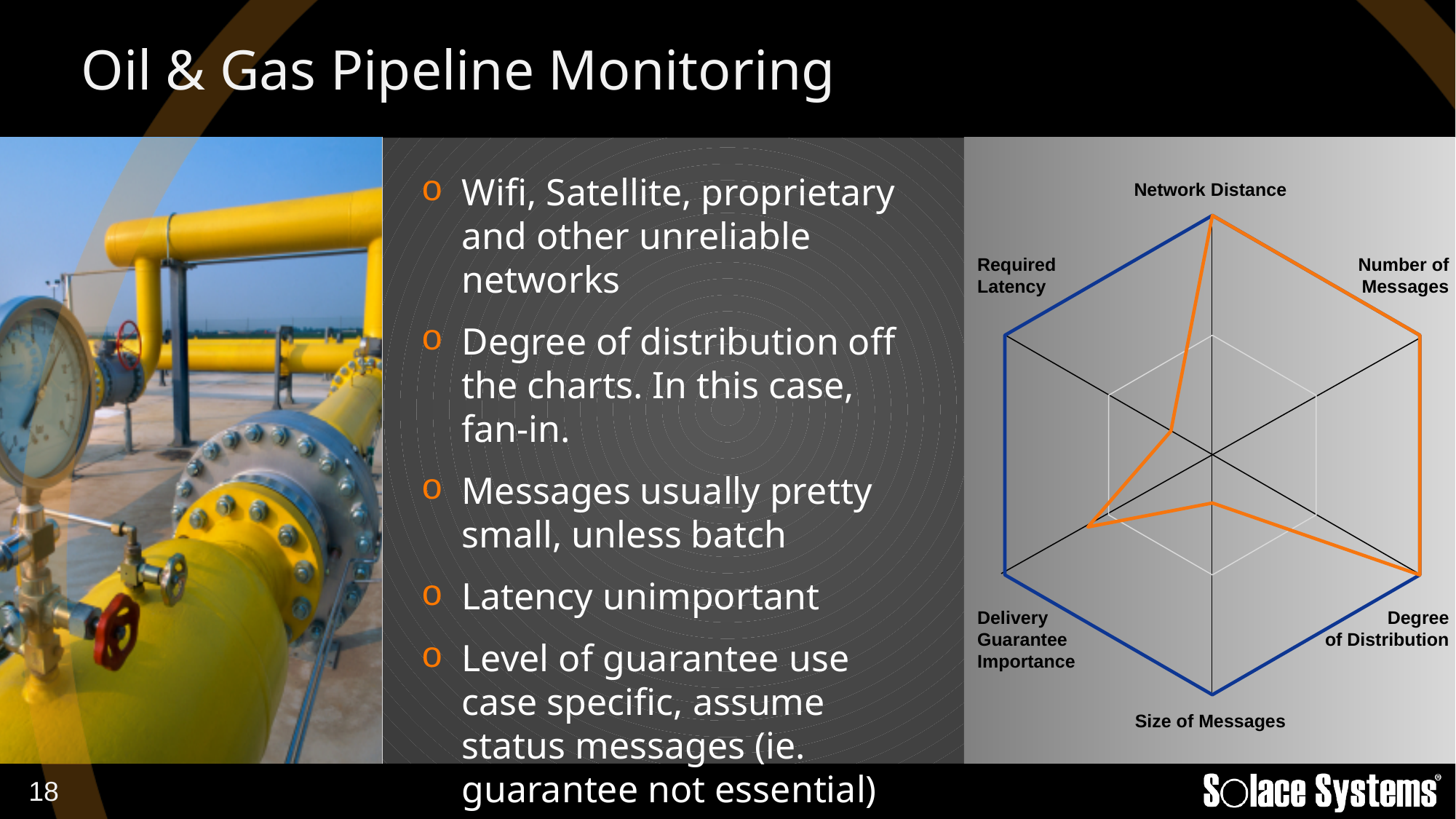
On the radar chart, which is larger for the orange series: Number of Messages or Required Latency? Number of Messages What kind of chart is shown on the right side of the slide? Radar chart On the radar chart, which is larger for the orange series: Network Distance or Size of Messages? Network Distance Which axis label appears at the bottom of the radar chart? Size of Messages Which axis label appears at the top of the radar chart? Network Distance On the radar chart, which is larger for the orange series: Degree of Distribution or Required Latency? Degree of Distribution How many data series are plotted on the radar chart? 2 How many axes (categories) does the radar chart have? 6